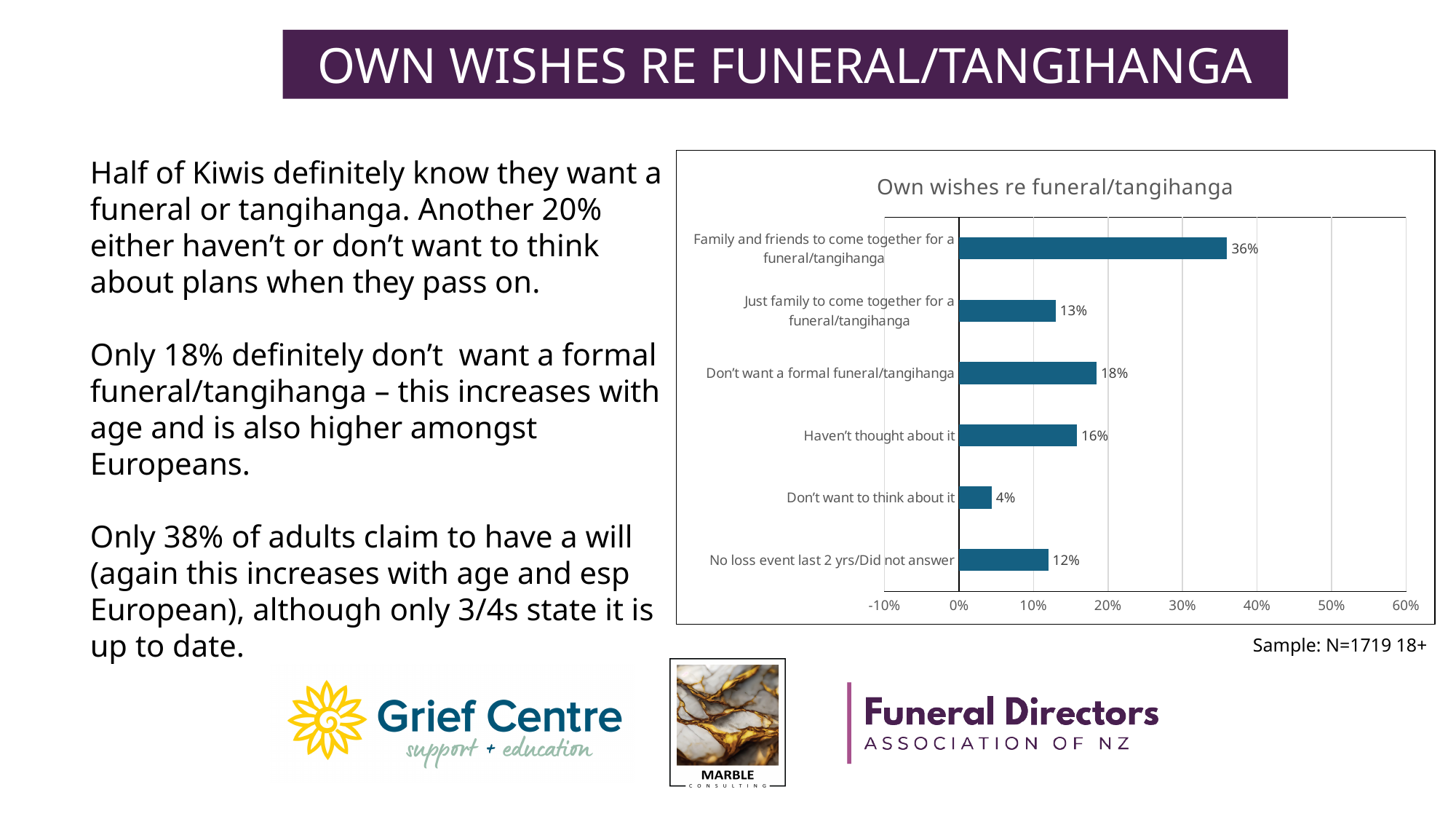
How many categories are shown in the chart? 6 Is the value for "Just family to come together for a funeral/tangihanga" greater or less than 20%? less What is the difference between "Family and friends to come together for a funeral/tangihanga" and "Just family to come together for a funeral/tangihanga"? 23% Which is larger: "Don't want a formal funeral/tangihanga" or "Haven't thought about it"? Don't want a formal funeral/tangihanga Which category has the highest value? Family and friends to come together for a funeral/tangihanga Which category has the lowest value? Don't want to think about it What is the value for "No loss event last 2 yrs/Did not answer"? 12% What is the value for "Haven't thought about it"? 16% What is the value for "Family and friends to come together for a funeral/tangihanga"? 36% What is the value for "Don't want a formal funeral/tangihanga"? 18% What kind of chart is shown on the slide? Bar chart What is the title of the chart? Own wishes re funeral/tangihanga